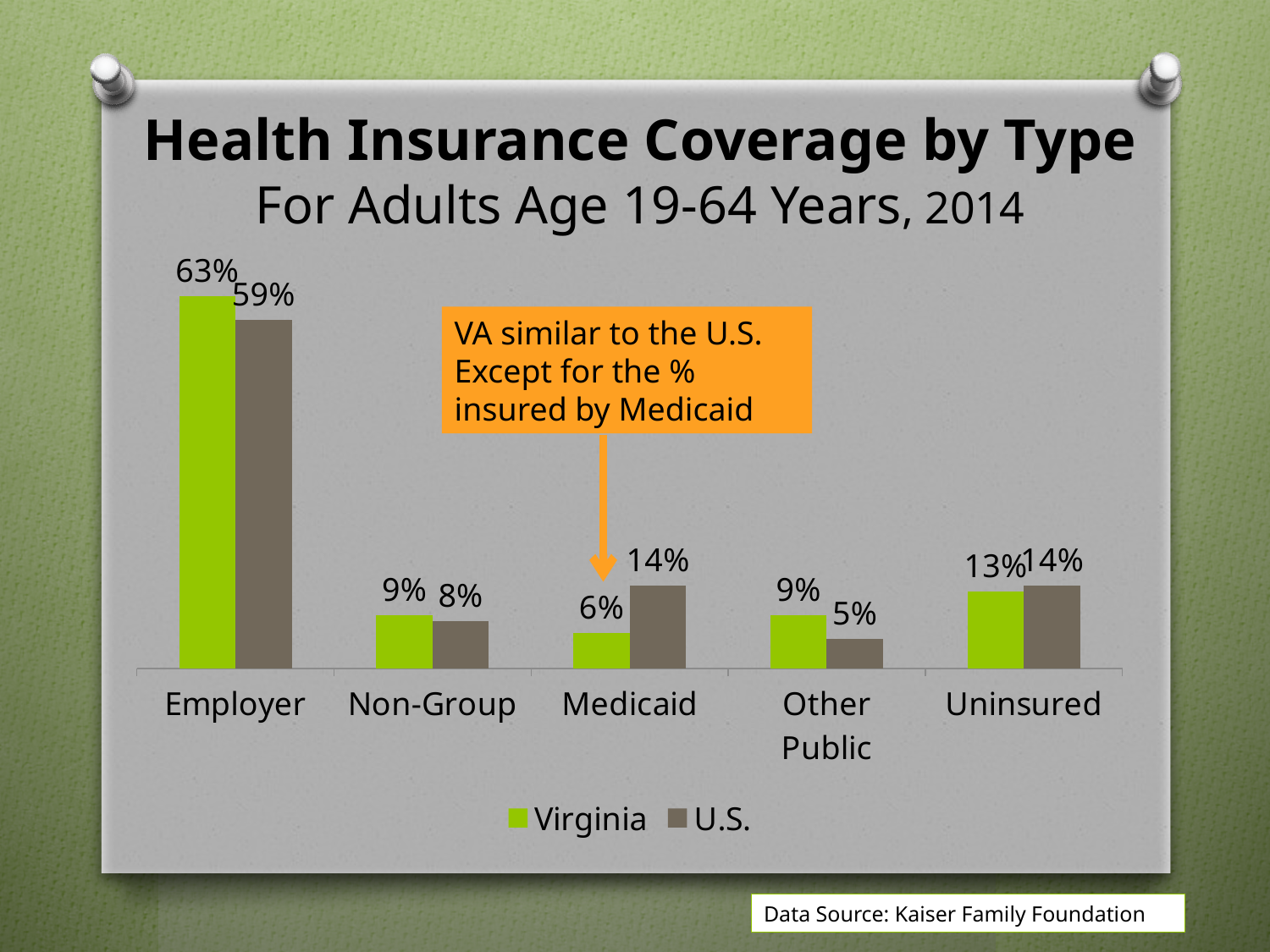
Which coverage type has the lowest U.S. value? Other Public How many coverage types are shown on the x axis? 5 Which coverage type has the highest Virginia value? Employer How many series does the legend list? 2 What kind of chart is shown on the slide? Bar chart What is the Virginia value for Uninsured? 13% What is the Virginia value for Employer coverage? 63% Which is larger for Other Public coverage, the Virginia value or the U.S. value? Virginia What is the U.S. value for Medicaid coverage? 14% What is the difference between the U.S. and Virginia values for Medicaid? 8% What is the U.S. value for Other Public coverage? 5% Which series is shown in green in the legend? Virginia